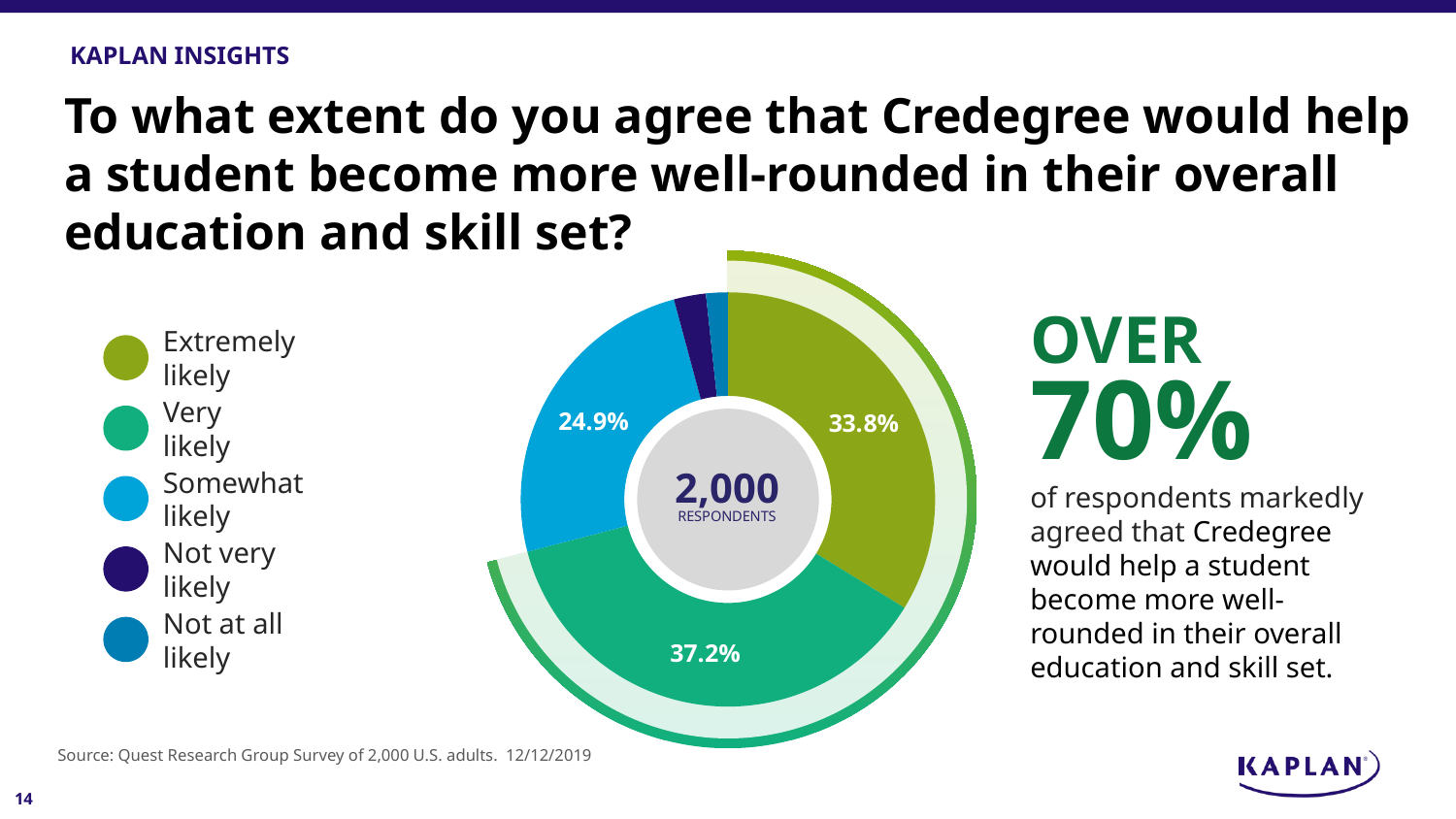
What kind of chart is shown on the slide? doughnut chart Which is larger, the share for "Very likely" or the share for "Extremely likely"? Very likely Which response category is shown in dark navy blue in the legend? Not very likely What is the combined share of "Extremely likely" and "Very likely"? 71.0% What percentage of respondents said "Somewhat likely"? 24.9% What percentage of respondents said "Very likely"? 37.2% How many response categories does the legend list? 5 What percentage of respondents said "Extremely likely"? 33.8% How many respondents does the centre of the chart say took part? 2,000 What is the difference in percentage points between "Very likely" and "Extremely likely"? 3.4 What is the difference in percentage points between "Extremely likely" and "Somewhat likely"? 8.9 Which response category has the largest share of the chart? Very likely